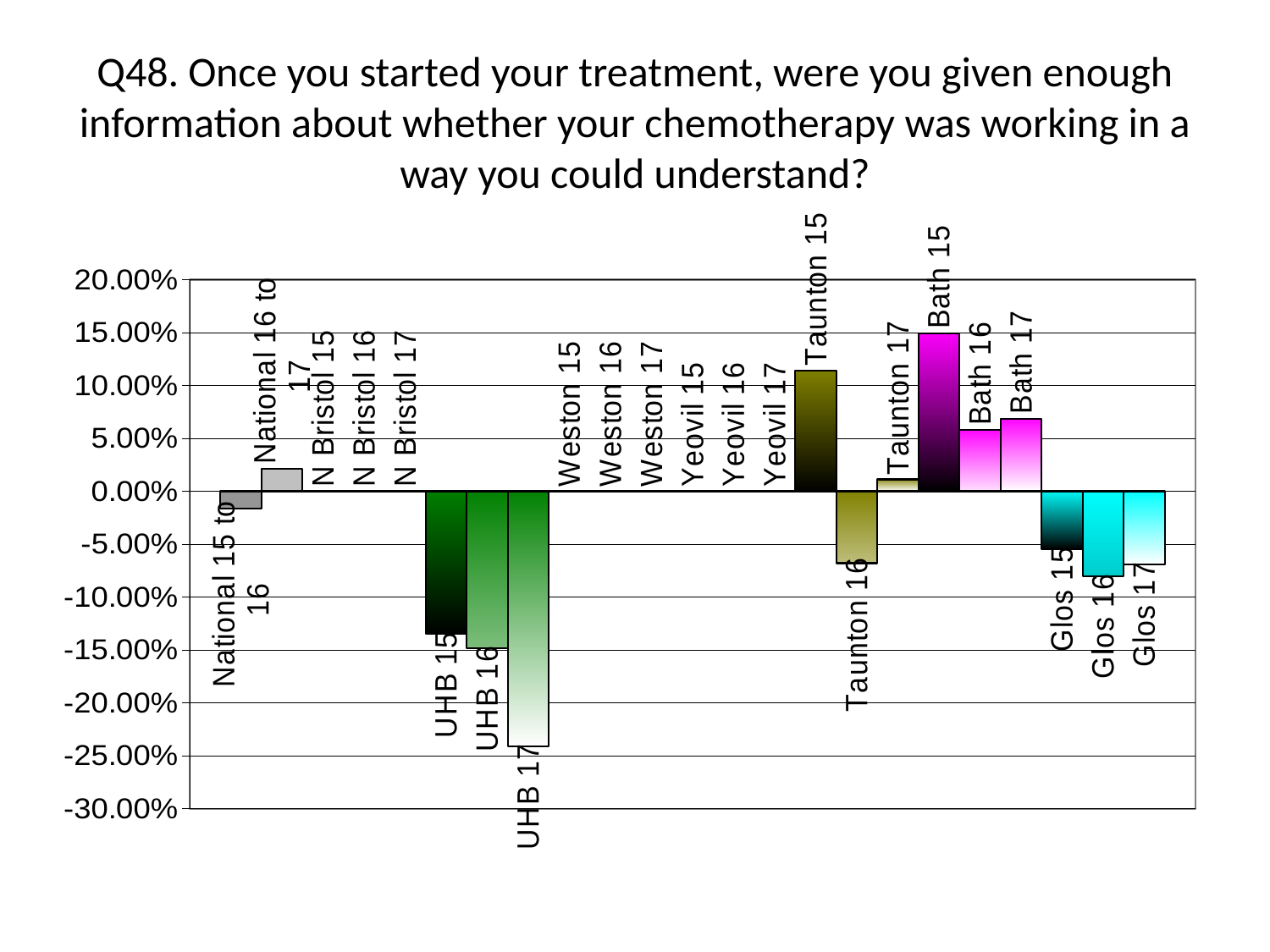
Which is larger, the value for Bath 15 or the value for Taunton 15? Bath 15 Is the value for Taunton 15 greater or less than 10.00%? greater Which is larger, the value for UHB 15 or the value for UHB 17? UHB 15 Is the value for Bath 16 greater or less than 5.00%? greater What is the question number shown at the start of the chart title? Q48 Is the value for Glos 16 greater or less than -5.00%? less Which category has the highest value in the chart? Bath 15 How many categories are shown along the x axis of the chart? 23 Do the values for UHB rise or fall from UHB 15 to UHB 17? fall Which category has the lowest value in the chart? UHB 17 What kind of chart is shown on the slide? bar chart